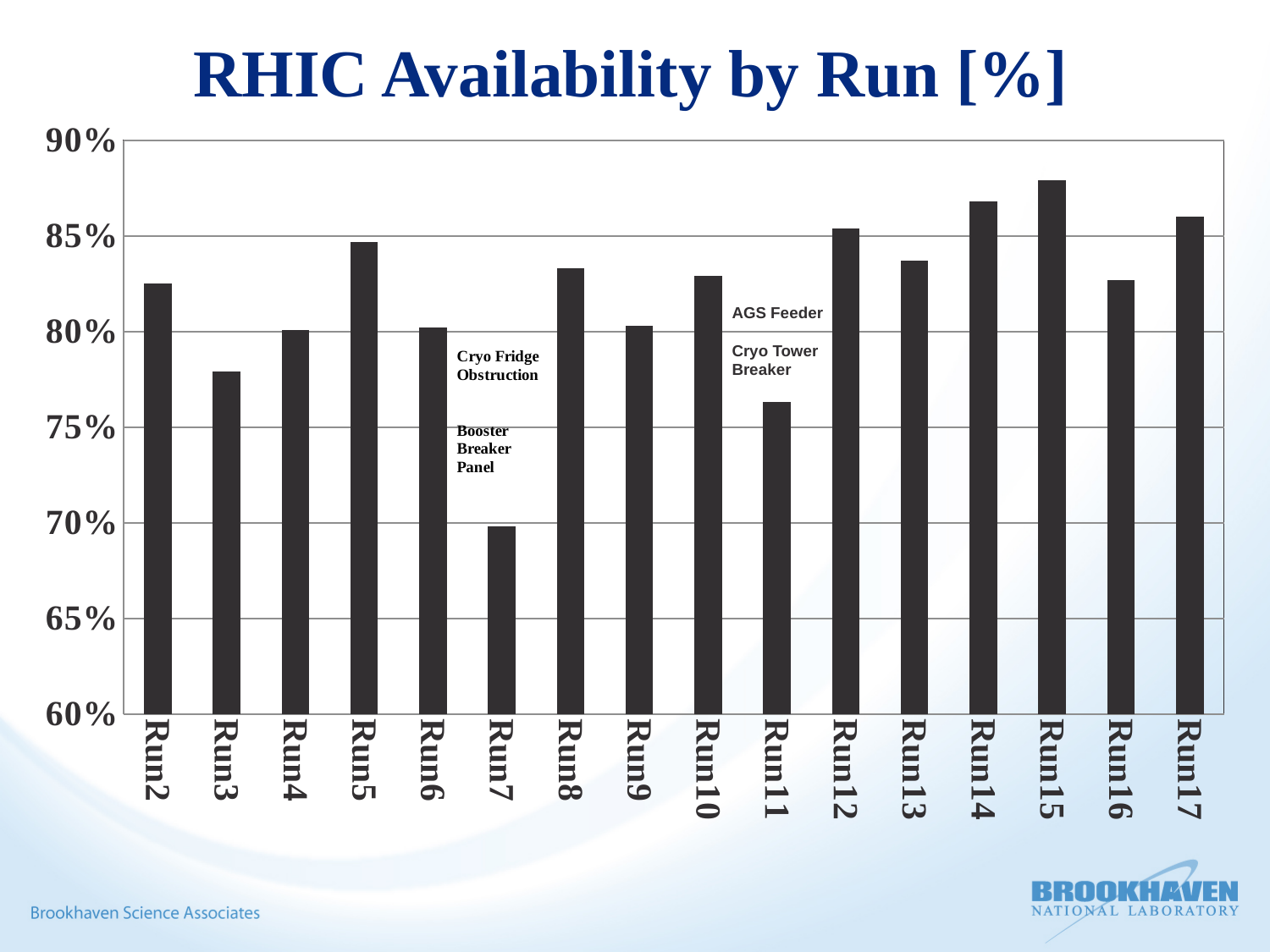
Which has the higher availability, Run12 or Run11? Run12 How many runs (bars) are plotted in the chart? 16 Which run has the highest availability? Run15 Is the value for Run3 greater or less than 80%? less What is the title of the chart? RHIC Availability by Run [%] What kind of chart is shown on the slide? Bar chart Which has the higher availability, Run5 or Run3? Run5 Is the value for Run11 greater or less than 75%? greater What annotations are written next to the Run11 bar? AGS Feeder; Cryo Tower Breaker Which run has the lowest availability? Run7 Is the value for Run15 greater or less than 85%? greater